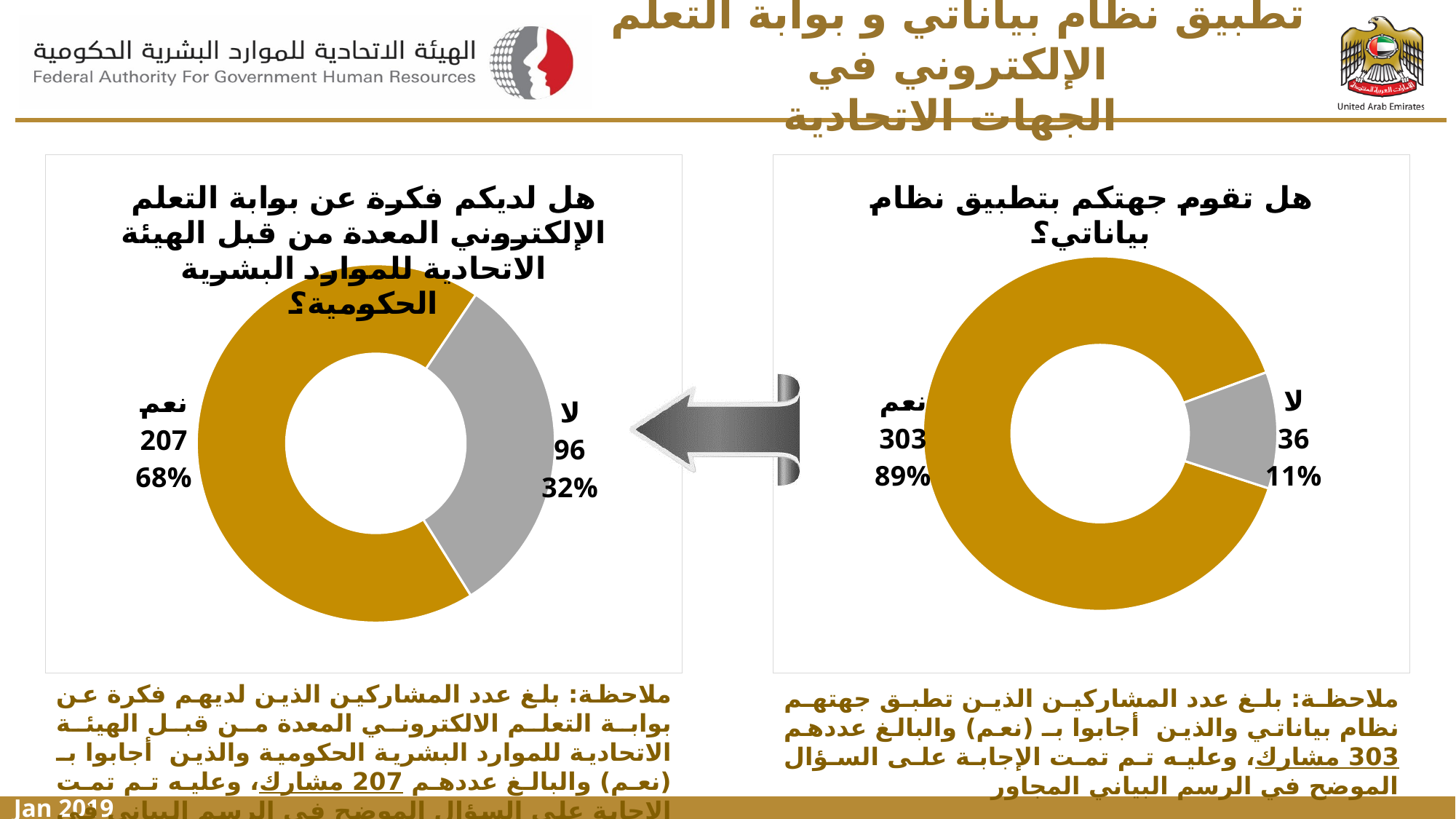
In the right-hand chart (هل تقوم جهتكم بتطبيق نظام بياناتي؟), what percentage of respondents answered لا? 11% In the right-hand chart (هل تقوم جهتكم بتطبيق نظام بياناتي؟), how many respondents answered نعم? 303 In the left-hand chart about the e-learning portal (بوابة التعلم الإلكتروني), what colour is the نعم slice? Gold/orange In the left-hand chart about the e-learning portal (بوابة التعلم الإلكتروني), what percentage of respondents answered لا? 32% In the right-hand chart (هل تقوم جهتكم بتطبيق نظام بياناتي؟), what is the difference between the number of نعم and لا responses? 267 What kind of chart is used on the right-hand side of the slide (هل تقوم جهتكم بتطبيق نظام بياناتي؟)? Donut (pie) chart In the left-hand chart about the e-learning portal (بوابة التعلم الإلكتروني), which answer has the larger share, نعم or لا? نعم In the left-hand chart about the e-learning portal (بوابة التعلم الإلكتروني), how many respondents answered لا? 96 In the left-hand chart about the e-learning portal (بوابة التعلم الإلكتروني), what is the total number of responses shown? 303 In the left-hand chart about the e-learning portal (بوابة التعلم الإلكتروني), how many respondents answered نعم? 207 In the right-hand chart (هل تقوم جهتكم بتطبيق نظام بياناتي؟), how many respondents answered لا? 36 How many categories does the right-hand chart (هل تقوم جهتكم بتطبيق نظام بياناتي؟) show? 2